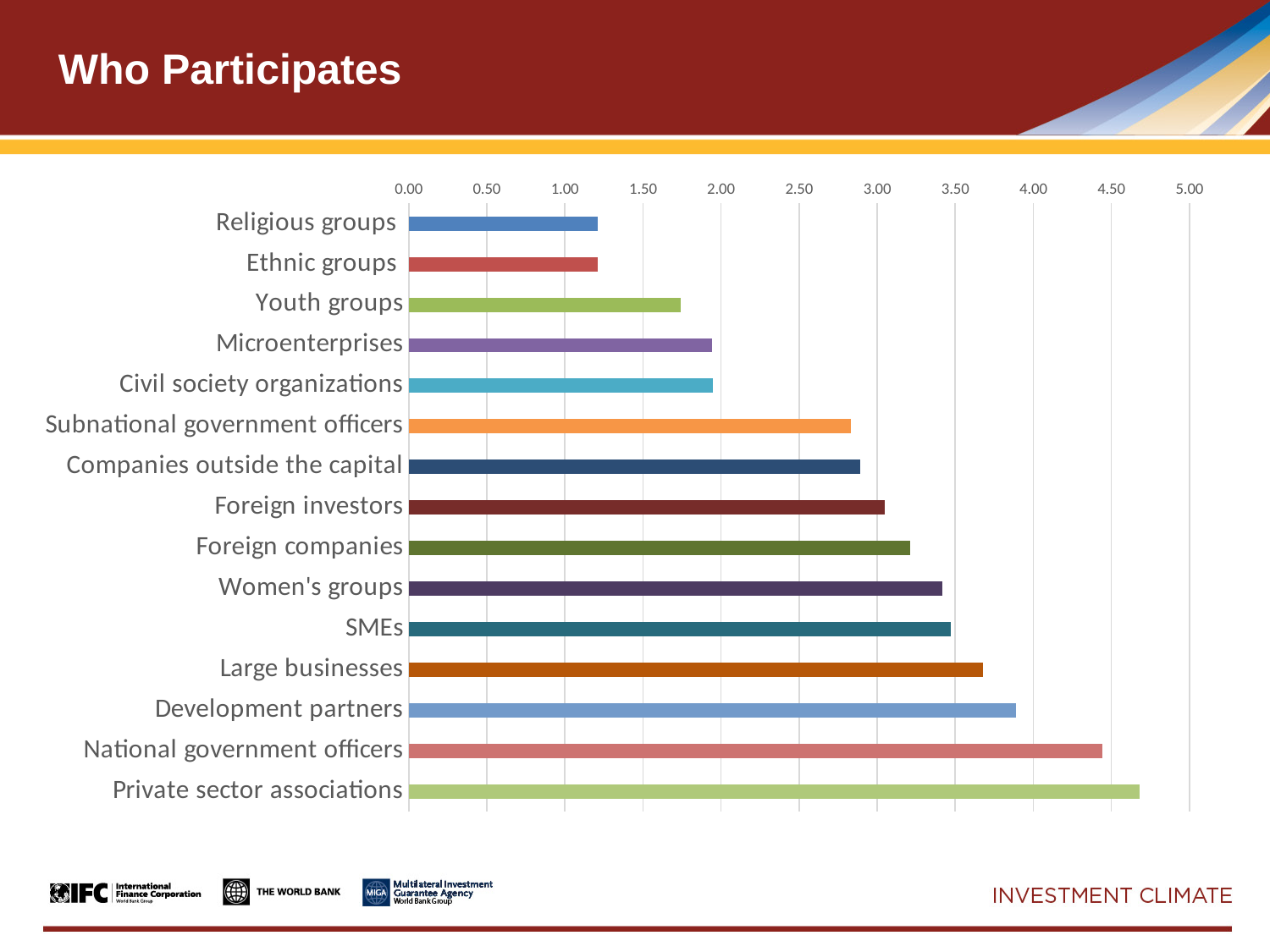
Is the value for Youth groups greater or less than 1.50? greater Which category has the highest value in the chart? Private sector associations Is the value for National government officers greater or less than 4.00? greater How many categories are plotted in the chart? 15 Is the value for Subnational government officers greater or less than 3.00? less Which has a larger value, Development partners or Large businesses? Development partners What type of chart is shown on the slide? bar chart What is the title of the slide containing the chart? Who Participates Which has a larger value, Women's groups or Foreign investors? Women's groups